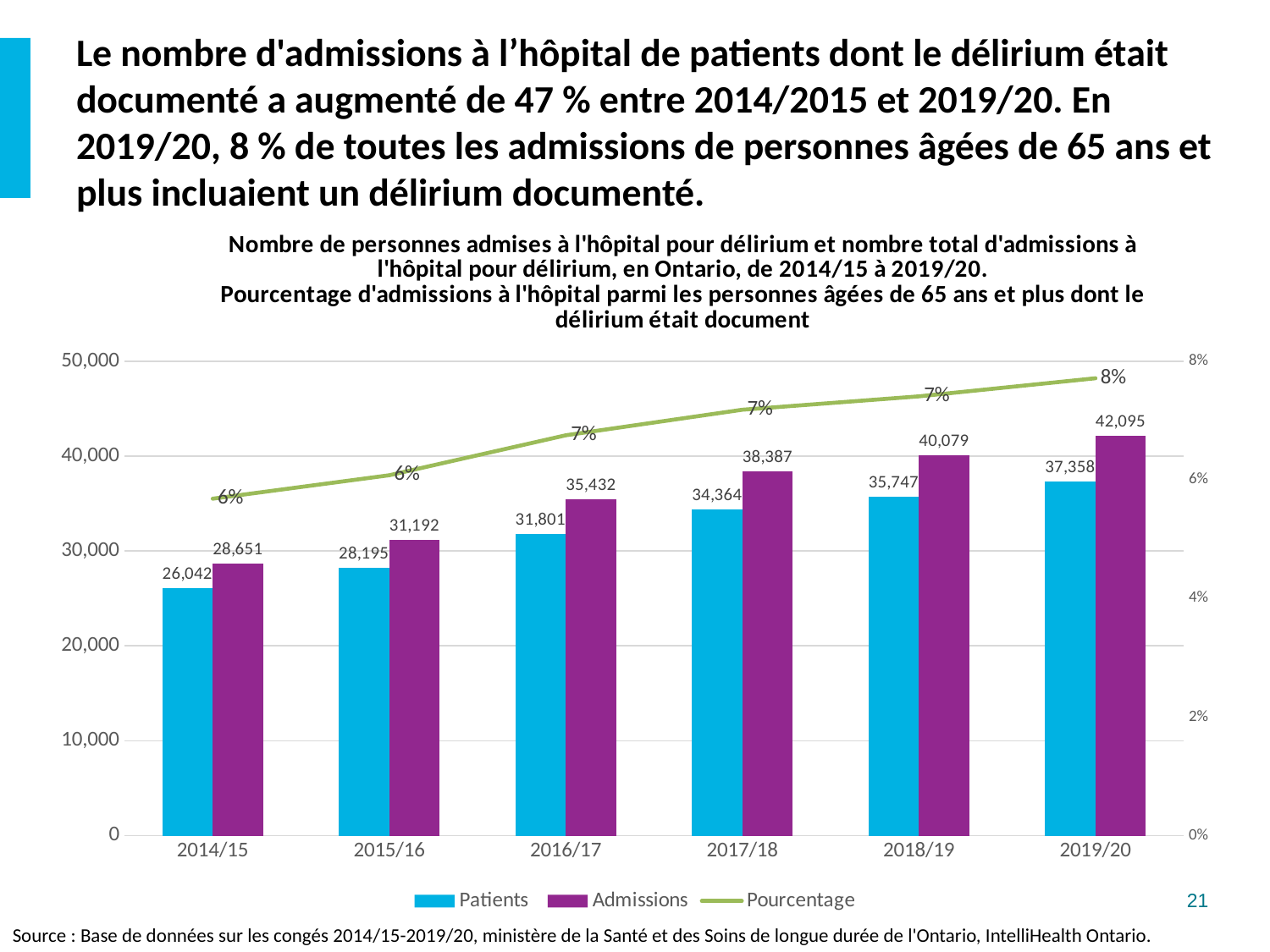
How many years are shown on the x axis? 6 Which year has the lowest value for Admissions? 2014/15 What is the value for Admissions in 2019/20? 42,095 What is the difference between Admissions and Patients in 2019/20? 4,737 What is the Pourcentage value for 2019/20? 8% What is the value for Admissions in 2017/18? 38,387 Which year has the highest value for Patients? 2019/20 Which is larger in 2016/17, Patients or Admissions? Admissions Do the Admissions values rise or fall from 2014/15 to 2019/20? rise What is the value for Patients in 2014/15? 26,042 Is the value for Patients in 2018/19 greater or less than 30,000? greater How many series does the legend list? 3